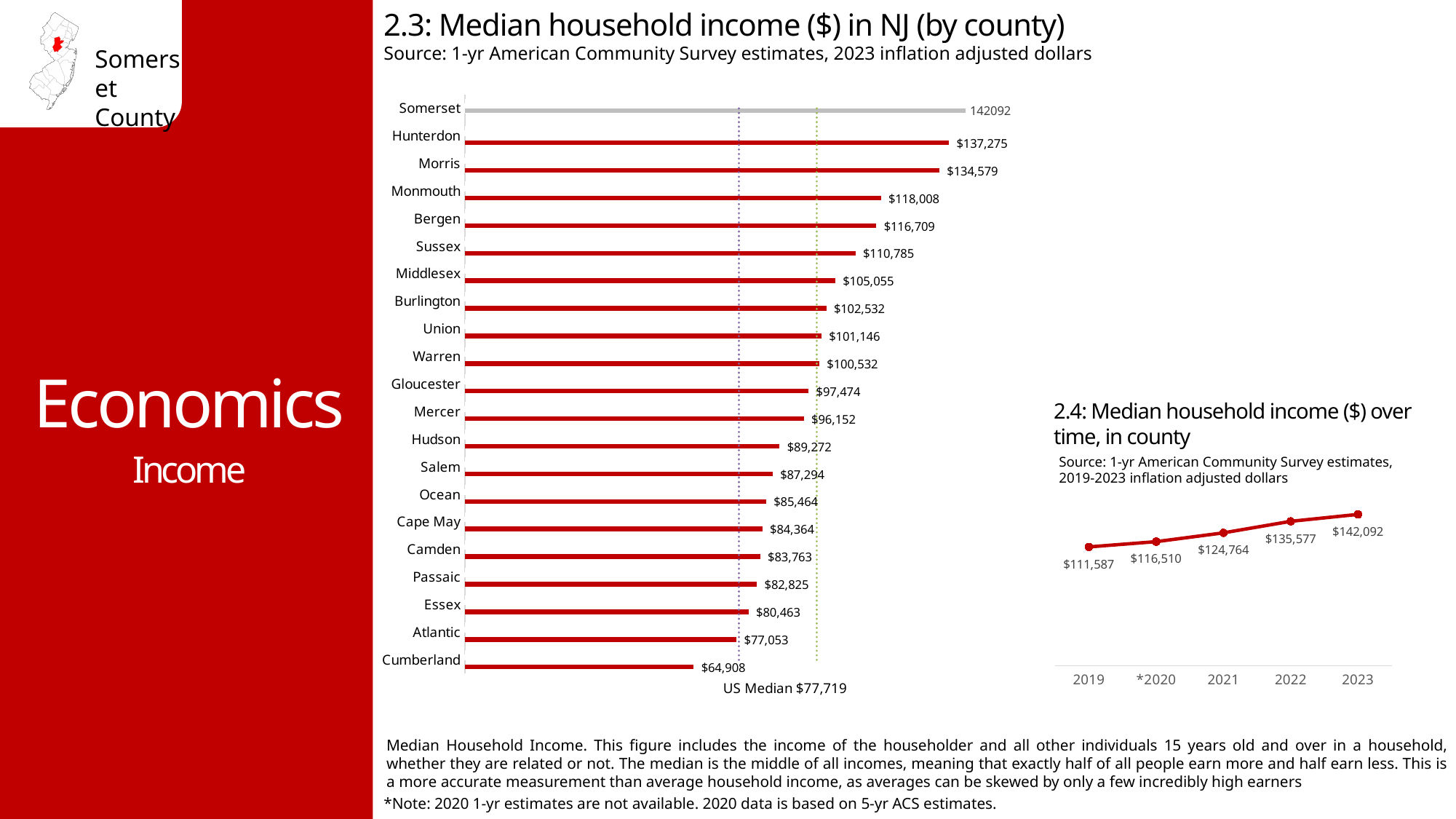
In chart 2.3 (Median household income in NJ by county), which county has the highest median household income? Somerset In chart 2.3 (Median household income in NJ by county), how many counties are plotted? 21 In chart 2.4 (Median household income over time, in county), what is the difference between the 2023 and 2019 values? $30,505 In chart 2.3 (Median household income in NJ by county), what US Median value is noted below the chart? $77,719 In chart 2.3 (Median household income in NJ by county), which county has the lowest median household income? Cumberland In chart 2.3 (Median household income in NJ by county), what is the median household income for Cumberland? $64,908 What kind of chart is chart 2.3 (Median household income in NJ by county)? Bar chart In chart 2.3 (Median household income in NJ by county), what is the difference between Hunterdon's and Morris's median household income? $2,696 In chart 2.4 (Median household income over time, in county), do the values rise or fall from 2019 to 2023? Rise In chart 2.4 (Median household income over time, in county), what is the median household income for 2021? $124,764 In chart 2.3 (Median household income in NJ by county), which county has a higher median household income, Bergen or Sussex? Bergen In chart 2.3 (Median household income in NJ by county), what is the median household income for Hunterdon? $137,275